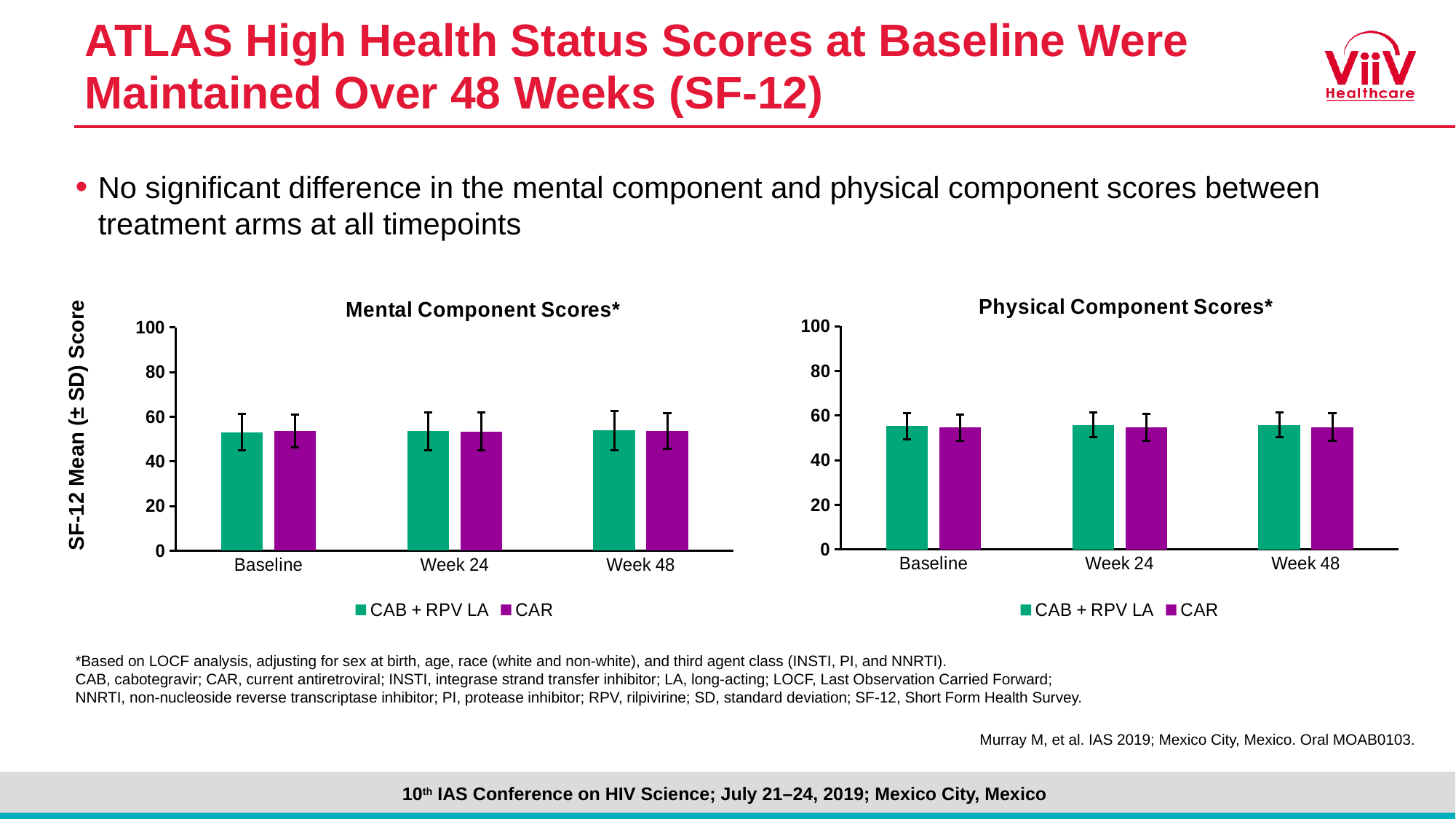
How many series does the legend of the Physical Component Scores chart list? 2 In the Physical Component Scores chart, is the value for CAB + RPV LA at Week 48 greater or less than 20? greater In the Mental Component Scores chart, is the value for CAR at Week 48 greater or less than 60? less In the Physical Component Scores chart, is the value for CAB + RPV LA at Week 24 greater or less than 60? less How many timepoint categories are shown on the x axis of the Mental Component Scores chart? 3 What kind of chart is the Mental Component Scores chart? bar chart What is the y-axis label shared by the two charts? SF-12 Mean (± SD) Score What are the two series named in the legend of the Mental Component Scores chart? CAB + RPV LA and CAR